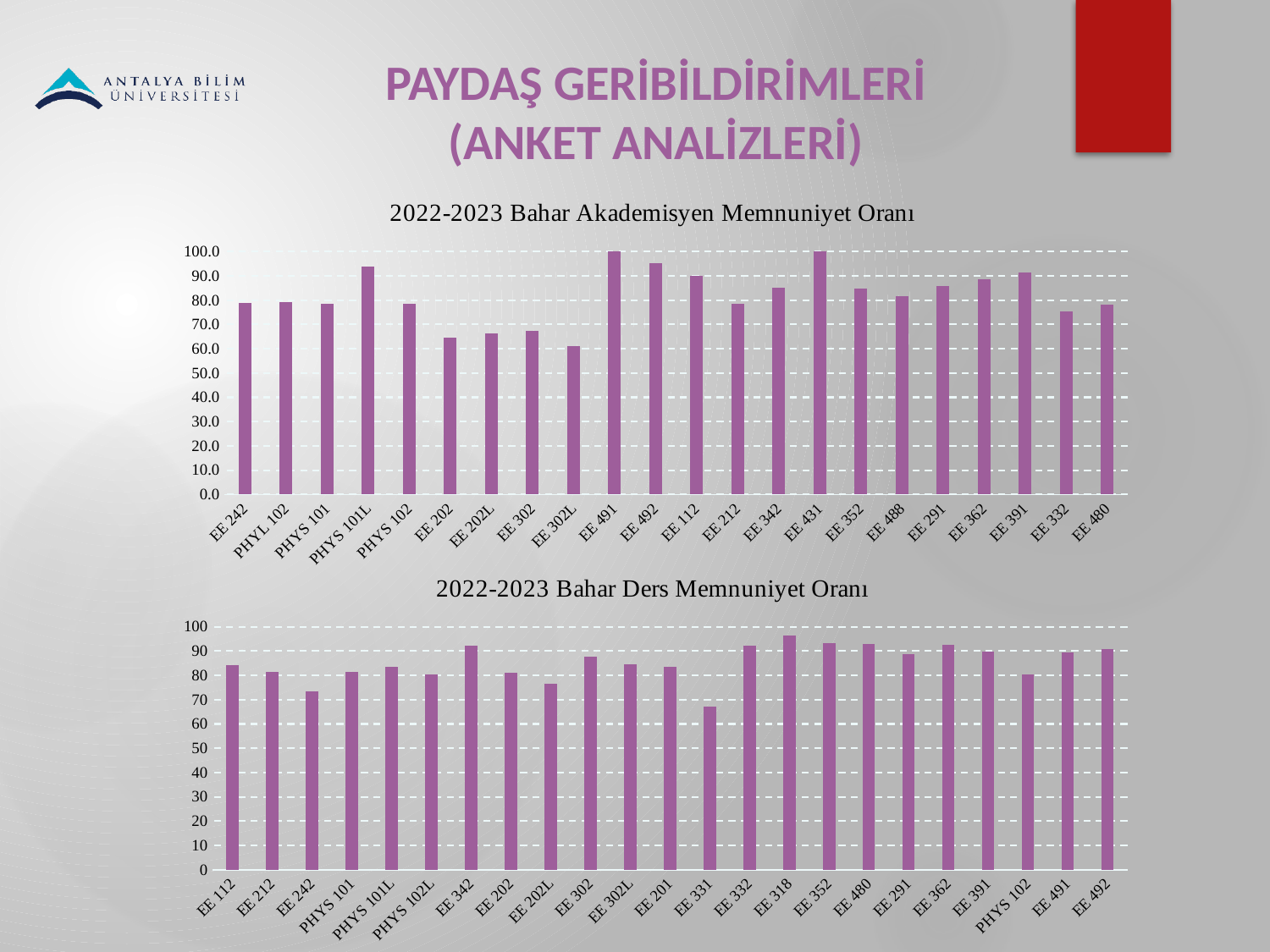
In the top chart (Akademisyen Memnuniyet Oranı), which category has the lowest value? EE 302L In the bottom chart (Ders Memnuniyet Oranı), is the value for EE 242 greater or less than 80? less What is the title of the bottom chart on the slide? 2022-2023 Bahar Ders Memnuniyet Oranı How many categories are shown on the x axis of the bottom chart (Ders Memnuniyet Oranı)? 23 In the bottom chart (Ders Memnuniyet Oranı), is the value for EE 318 greater or less than 90? greater In the top chart (Akademisyen Memnuniyet Oranı), is the value for EE 302L greater or less than 70.0? less In the bottom chart (Ders Memnuniyet Oranı), which category has the lowest value? EE 331 What kind of chart is the top chart titled '2022-2023 Bahar Akademisyen Memnuniyet Oranı'? bar chart How many categories are shown on the x axis of the top chart (Akademisyen Memnuniyet Oranı)? 22 In the top chart (Akademisyen Memnuniyet Oranı), which is larger, the value for EE 491 or the value for EE 302L? EE 491 In the bottom chart (Ders Memnuniyet Oranı), which category has the highest value? EE 318